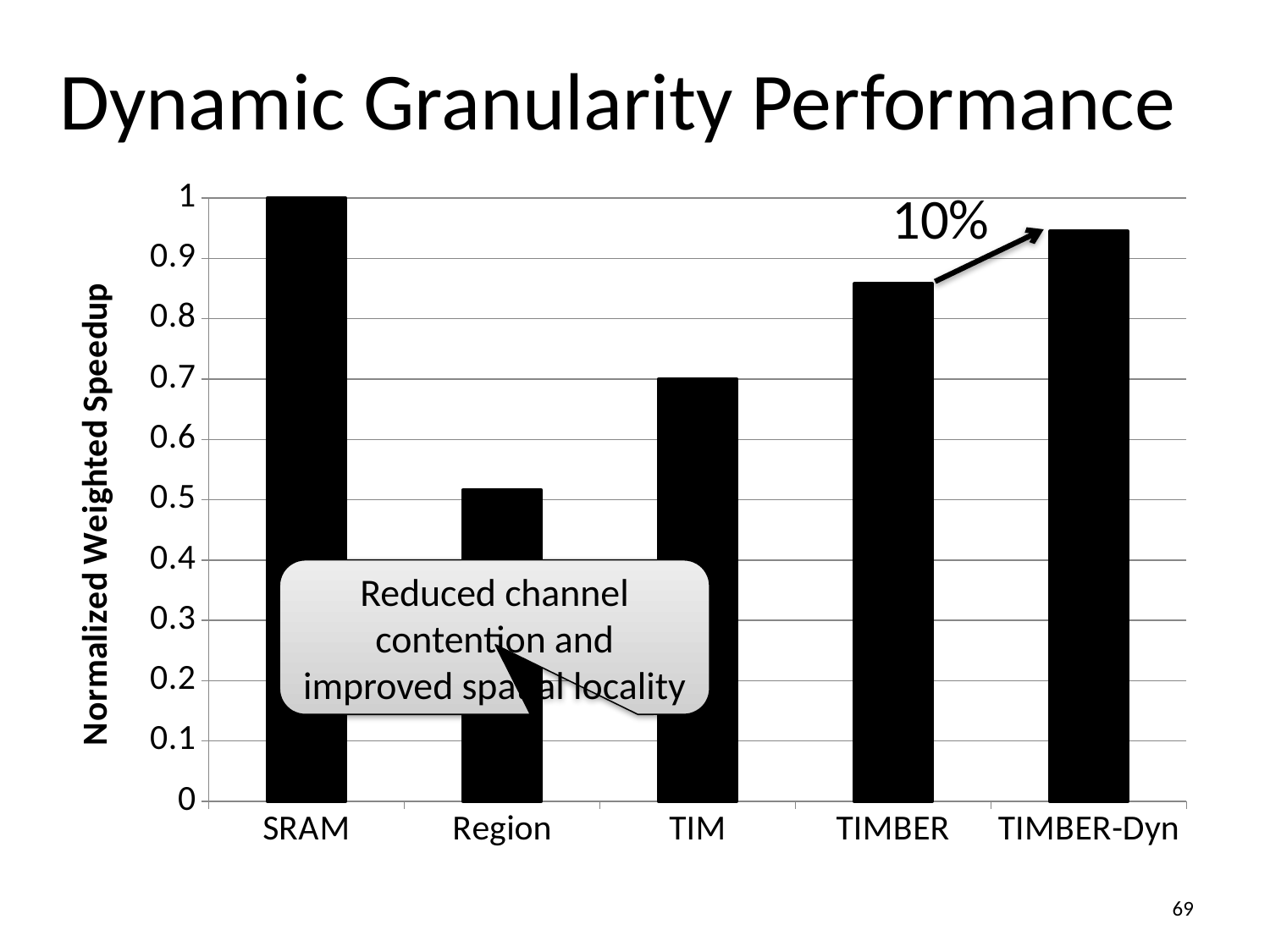
Is the value for Region greater or less than 0.6? less Which category has the highest normalized weighted speedup? SRAM Is the value for TIM greater or less than 0.6? greater What is the normalized weighted speedup for SRAM? 1 What kind of chart is shown on the slide? bar chart Which has a higher normalized weighted speedup, Region or TIM? TIM What is the label of the y axis of the chart? Normalized Weighted Speedup Is the value for TIMBER-Dyn greater or less than 0.9? greater Which category has the lowest normalized weighted speedup? Region How many categories are shown on the x axis of the chart? 5 Which has a higher normalized weighted speedup, TIMBER or TIMBER-Dyn? TIMBER-Dyn